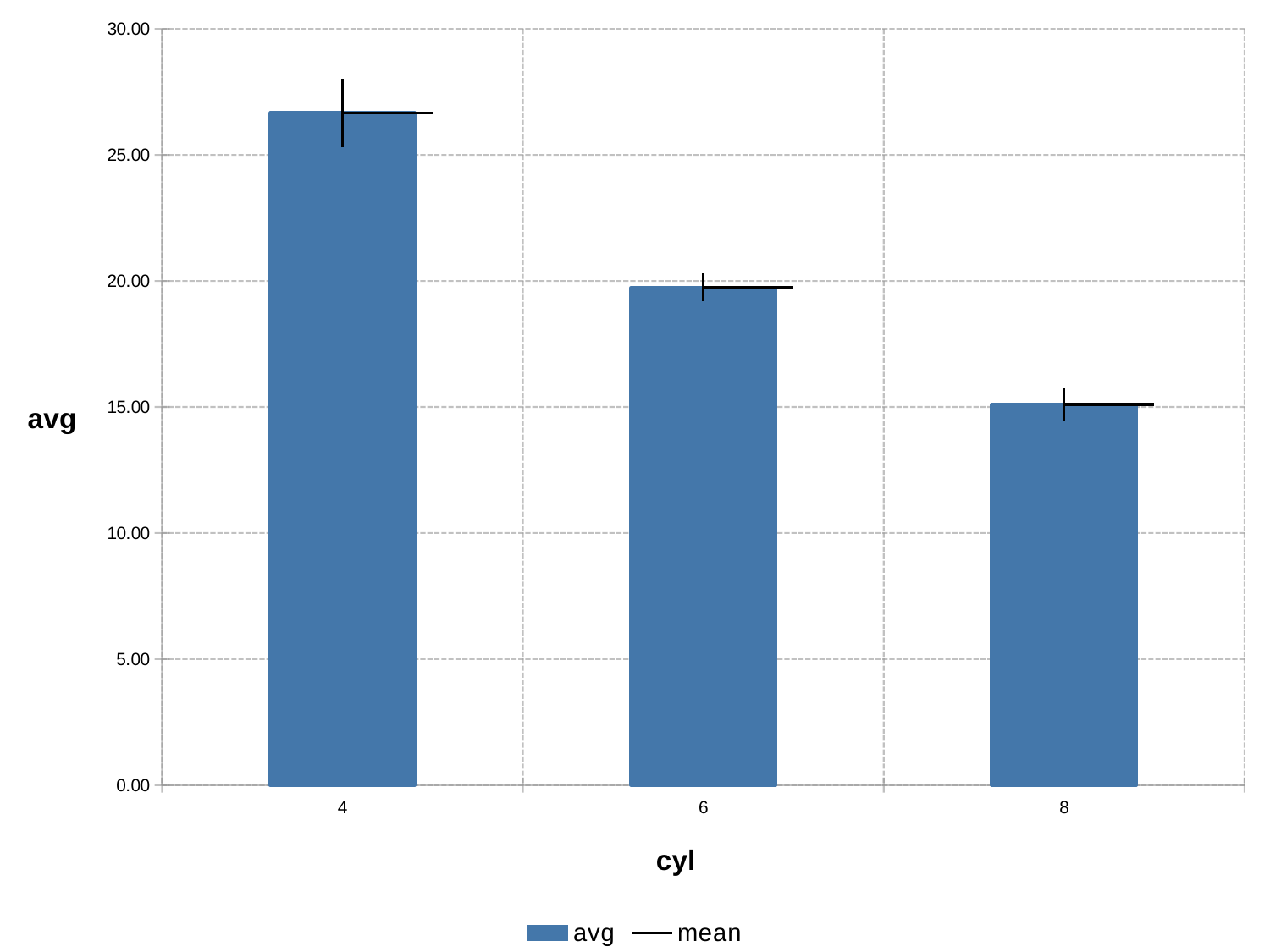
Is the avg value for cyl 4 greater or less than 25.00? greater Which cyl category has the lowest avg? 8 Do the avg values rise or fall as cyl increases along the x axis? fall How many categories are shown on the x axis? 3 Which has a larger avg, cyl 6 or cyl 8? 6 Is the avg value for cyl 6 greater or less than 20.00? less What are the two entries listed in the legend? avg and mean What is the label of the y axis? avg How many series does the legend list? 2 Which cyl category has the highest avg? 4 What kind of chart is shown on the slide? bar chart